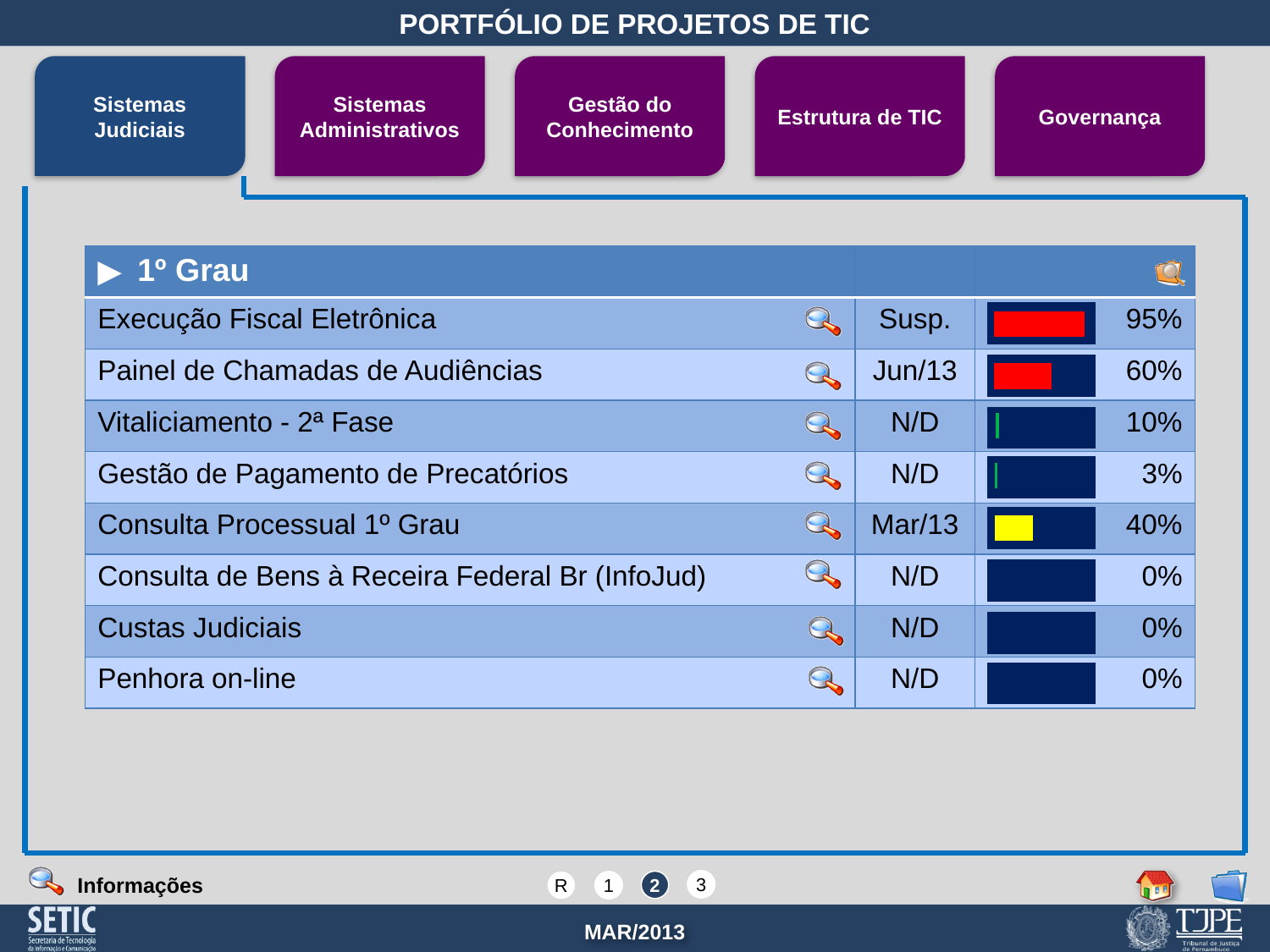
What completion percentage is shown for Gestão de Pagamento de Precatórios? 3% What completion percentage is shown for Execução Fiscal Eletrônica? 95% Which project has the highest completion percentage? Execução Fiscal Eletrônica How many projects are listed under 1º Grau? 8 What completion percentage is shown for Vitaliciamento - 2ª Fase? 10% What colour is the progress bar for Consulta Processual 1º Grau? Yellow Which has a higher completion percentage, Consulta Processual 1º Grau or Vitaliciamento - 2ª Fase? Consulta Processual 1º Grau How many projects show a completion percentage of 0%? 3 What completion percentage is shown for Consulta Processual 1º Grau? 40% What kind of chart is used to show the completion percentages? Bar chart What is the difference in completion percentage between Execução Fiscal Eletrônica and Painel de Chamadas de Audiências? 35% What completion percentage is shown for Painel de Chamadas de Audiências? 60%